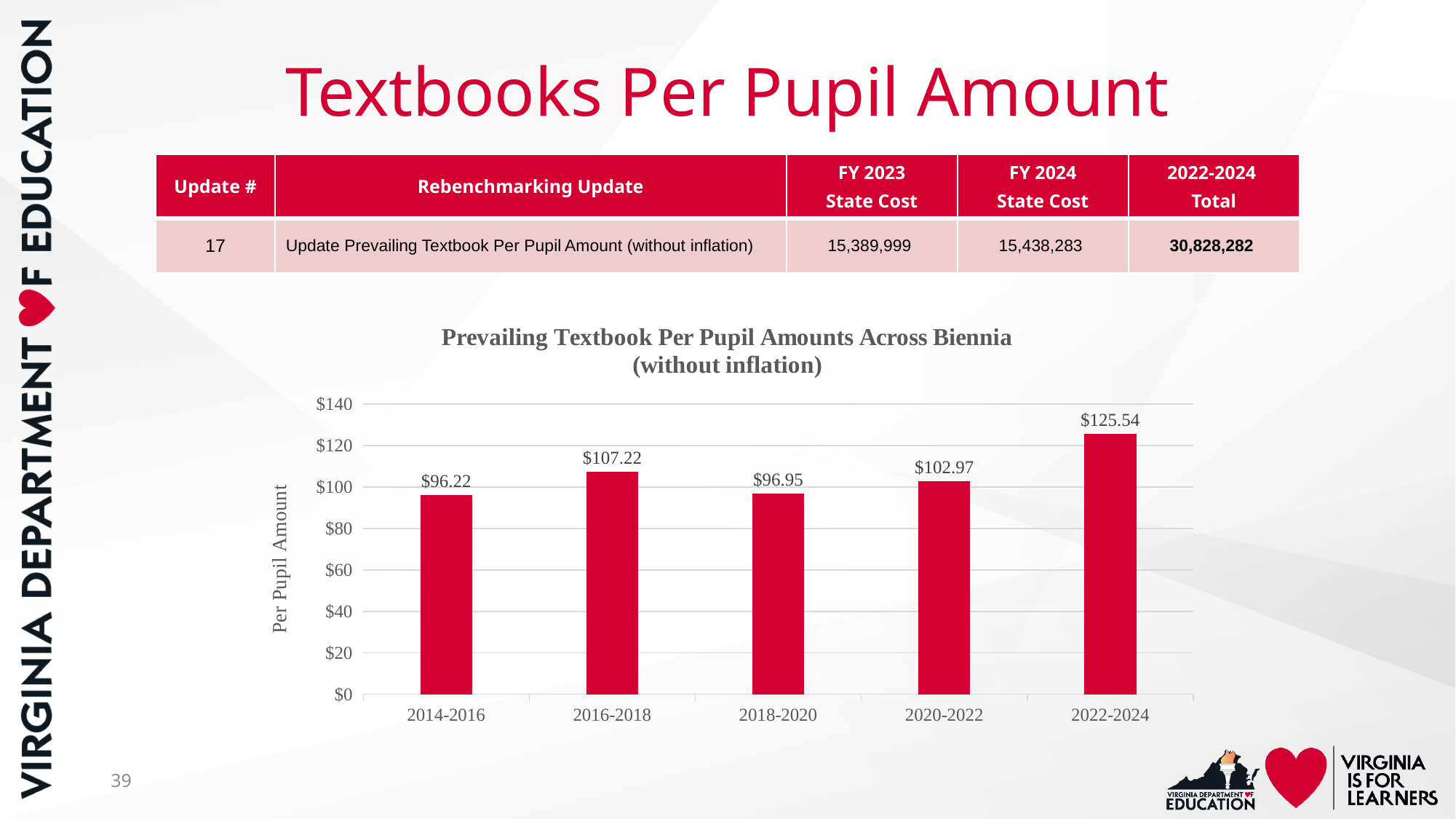
What is the per pupil amount for the 2022-2024 biennium? $125.54 What is the difference between the per pupil amounts for 2022-2024 and 2020-2022? $22.57 Which biennium has the highest per pupil amount? 2022-2024 What is the difference between the per pupil amounts for 2016-2018 and 2014-2016? $11.00 How many biennia are shown on the chart? 5 What is the title of the chart? Prevailing Textbook Per Pupil Amounts Across Biennia (without inflation) Which biennium has the lowest per pupil amount? 2014-2016 Is the per pupil amount for 2022-2024 greater or less than $120? greater What kind of chart is shown on the slide? Bar chart Which is larger, the per pupil amount for 2016-2018 or for 2020-2022? 2016-2018 What is the per pupil amount for the 2018-2020 biennium? $96.95 What is the per pupil amount for the 2014-2016 biennium? $96.22